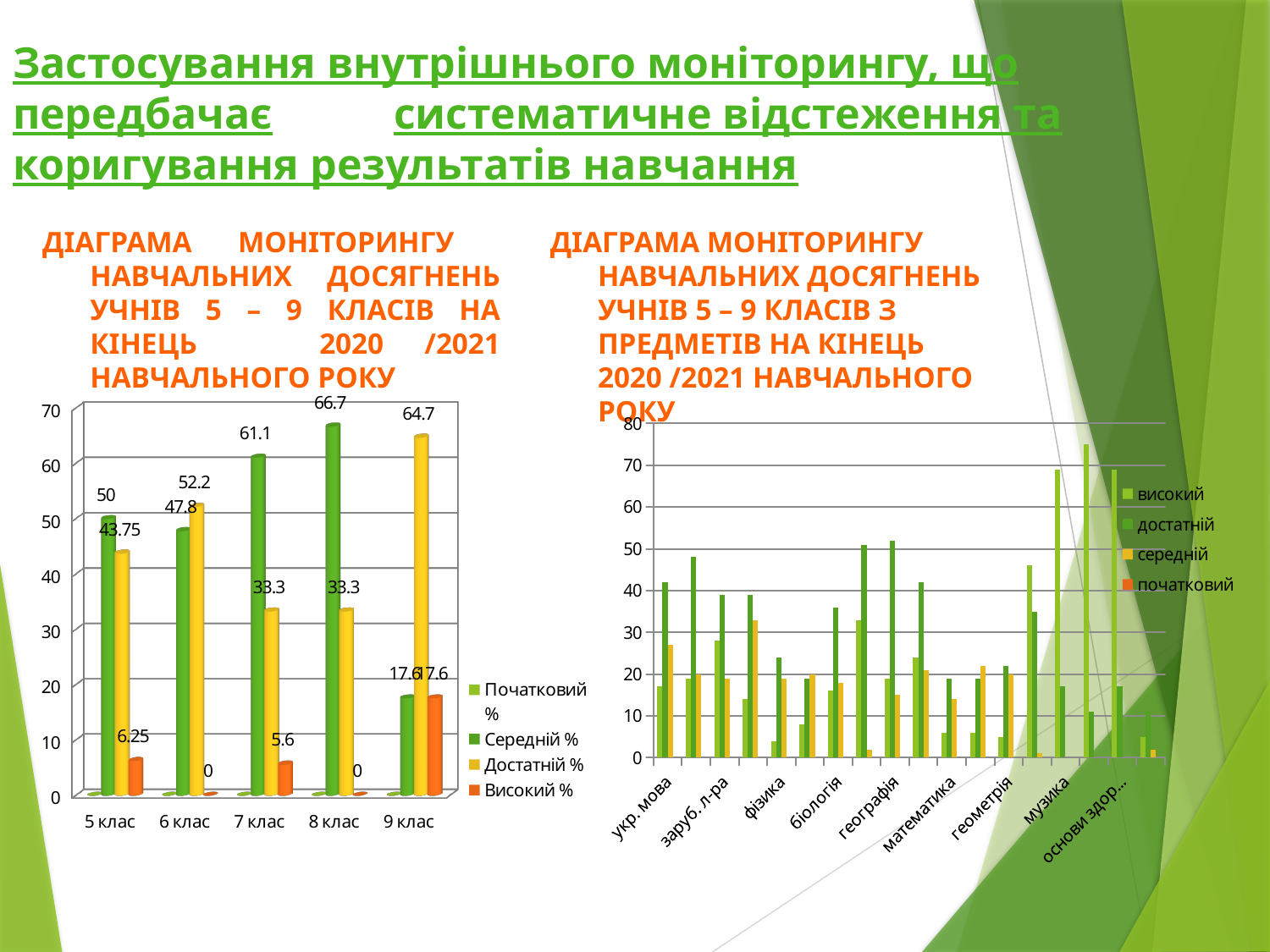
In the left chart, which class has the highest Середній % value? 8 клас How many classes are shown on the x axis of the left chart? 5 What kind of chart is the left chart? bar chart In the left chart, what is the Достатній % value for 9 клас? 64.7 In the right chart, is the достатній value for географія greater or less than 40? greater In the left chart, what is the Високий % value for 5 клас? 6.25 In the left chart, what is the difference between the Середній % values for 8 клас and 7 клас? 5.6 In the left chart, for 6 клас, which is larger: Середній % or Достатній %? Достатній % In the left chart, what is the Високий % value for 6 клас? 0 In the left chart (ДІАГРАМА МОНІТОРИНГУ ... 5 – 9 КЛАСІВ НА КІНЕЦЬ 2020/2021), what is the Середній % value for 8 клас? 66.7 How many series does the legend of the right chart (ДІАГРАМА МОНІТОРИНГУ ... З ПРЕДМЕТІВ) list? 4 How many series does the legend of the left chart list? 4